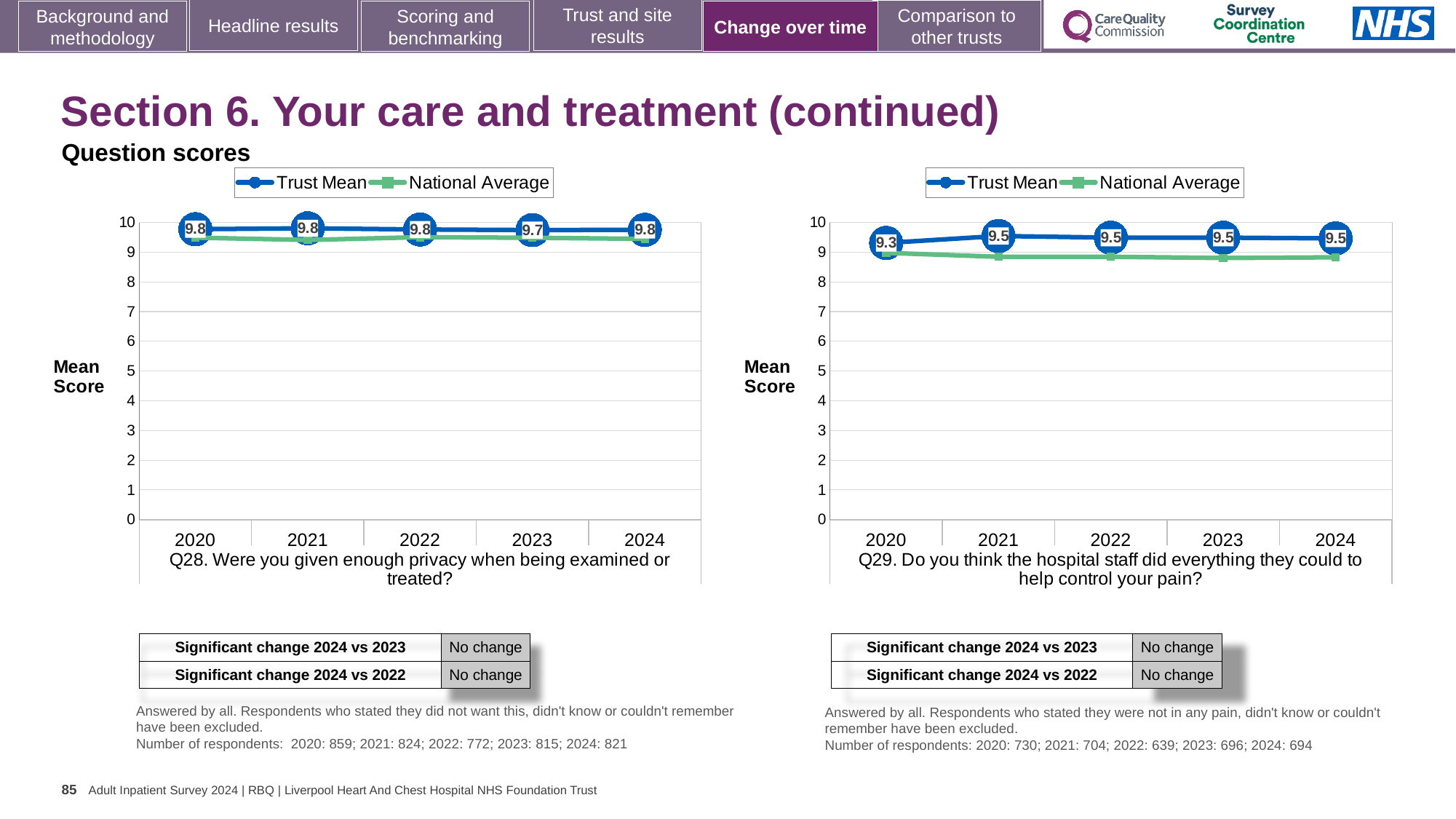
In the Q28 chart on the left, is the National Average value for 2020 greater or less than 9? greater What kind of chart is the Q28 chart on the left? Line chart In the Q29 chart on the right, which year has the lowest Trust Mean score? 2020 In the Q29 chart on the right, what is the Trust Mean score for 2020? 9.3 How many years are plotted on the x axis of the Q28 chart on the left? 5 In the Q28 chart on the left, what is the Trust Mean score for 2023? 9.7 In the Q29 chart on the right, which is higher in 2024, the Trust Mean or the National Average? Trust Mean In the Q29 chart on the right, what is the Trust Mean score for 2024? 9.5 In the Q28 chart on the left, which year has the lowest Trust Mean score? 2023 How many series does the legend of the Q29 chart on the right list? 2 In the Q29 chart on the right, what is the difference between the Trust Mean scores for 2021 and 2020? 0.2 What is the label on the y axis of the Q29 chart on the right? Mean Score